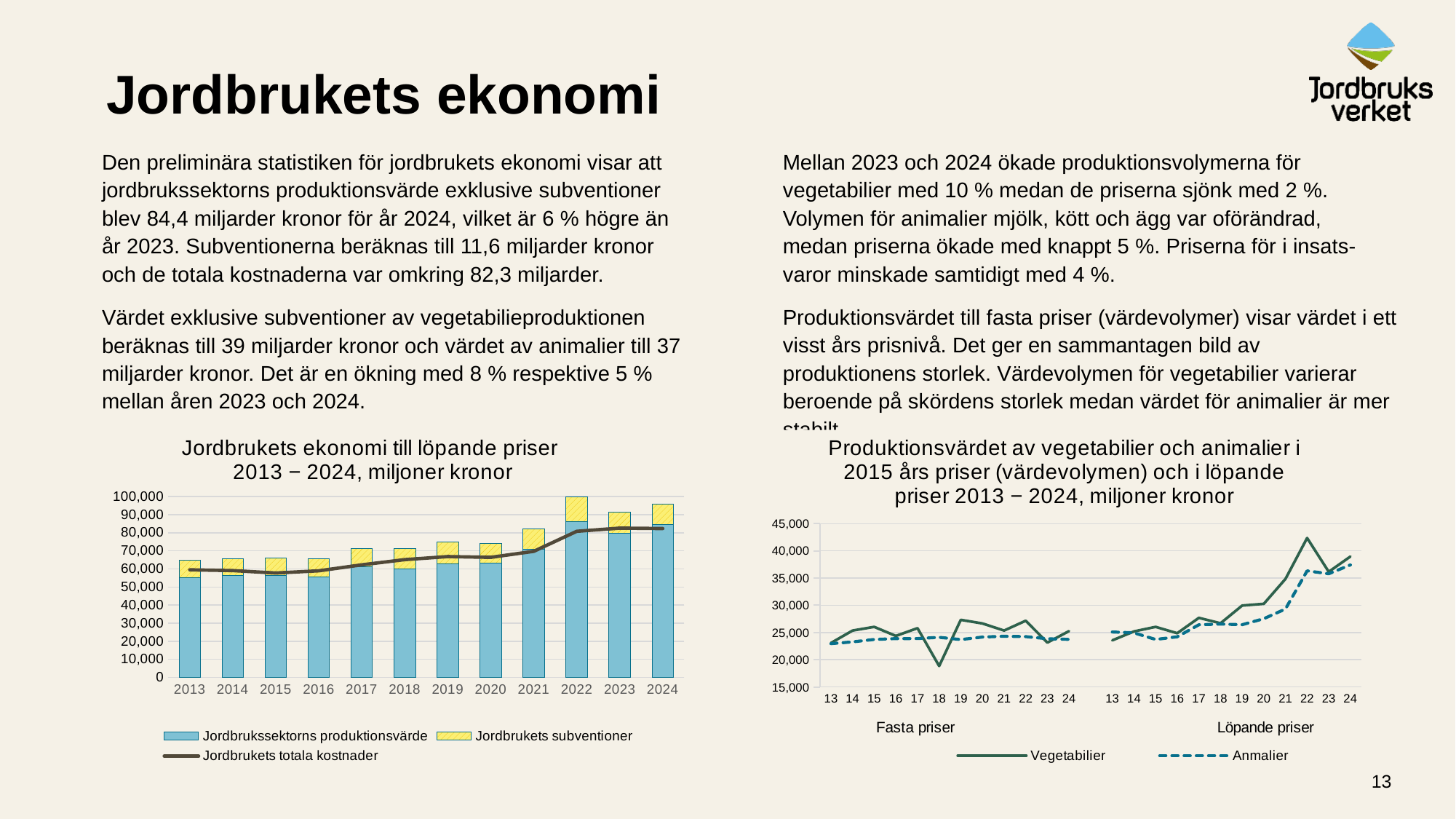
What kind of chart is the left chart, 'Jordbrukets ekonomi till löpande priser 2013 − 2024, miljoner kronor'? A bar chart with a line What kind of chart is the right chart, 'Produktionsvärdet av vegetabilier och animalier'? A line chart In the left chart 'Jordbrukets ekonomi till löpande priser', how many years are shown on the x axis? 12 In the right chart 'Produktionsvärdet av vegetabilier och animalier', do the Animalier values at löpande priser generally rise or fall from 13 to 24? rise In the left chart 'Jordbrukets ekonomi till löpande priser', is the value of Jordbrukets totala kostnader for 2013 greater or less than 70,000? less In the right chart 'Produktionsvärdet av vegetabilier och animalier', how many series does the legend list? 2 In the right chart 'Produktionsvärdet av vegetabilier och animalier', is the value of Vegetabilier at löpande priser in year 22 greater or less than 40,000? greater In the left chart 'Jordbrukets ekonomi till löpande priser', how many series does the legend list? 3 In the left chart 'Jordbrukets ekonomi till löpande priser', which year has the tallest stacked bar? 2022 In the right chart 'Produktionsvärdet av vegetabilier och animalier', in which year is Vegetabilier at fasta priser lowest? 18 In the left chart 'Jordbrukets ekonomi till löpande priser', is the total stacked bar for 2022 greater or less than 90,000? greater In the left chart 'Jordbrukets ekonomi till löpande priser', which series is drawn as a line rather than bars? Jordbrukets totala kostnader